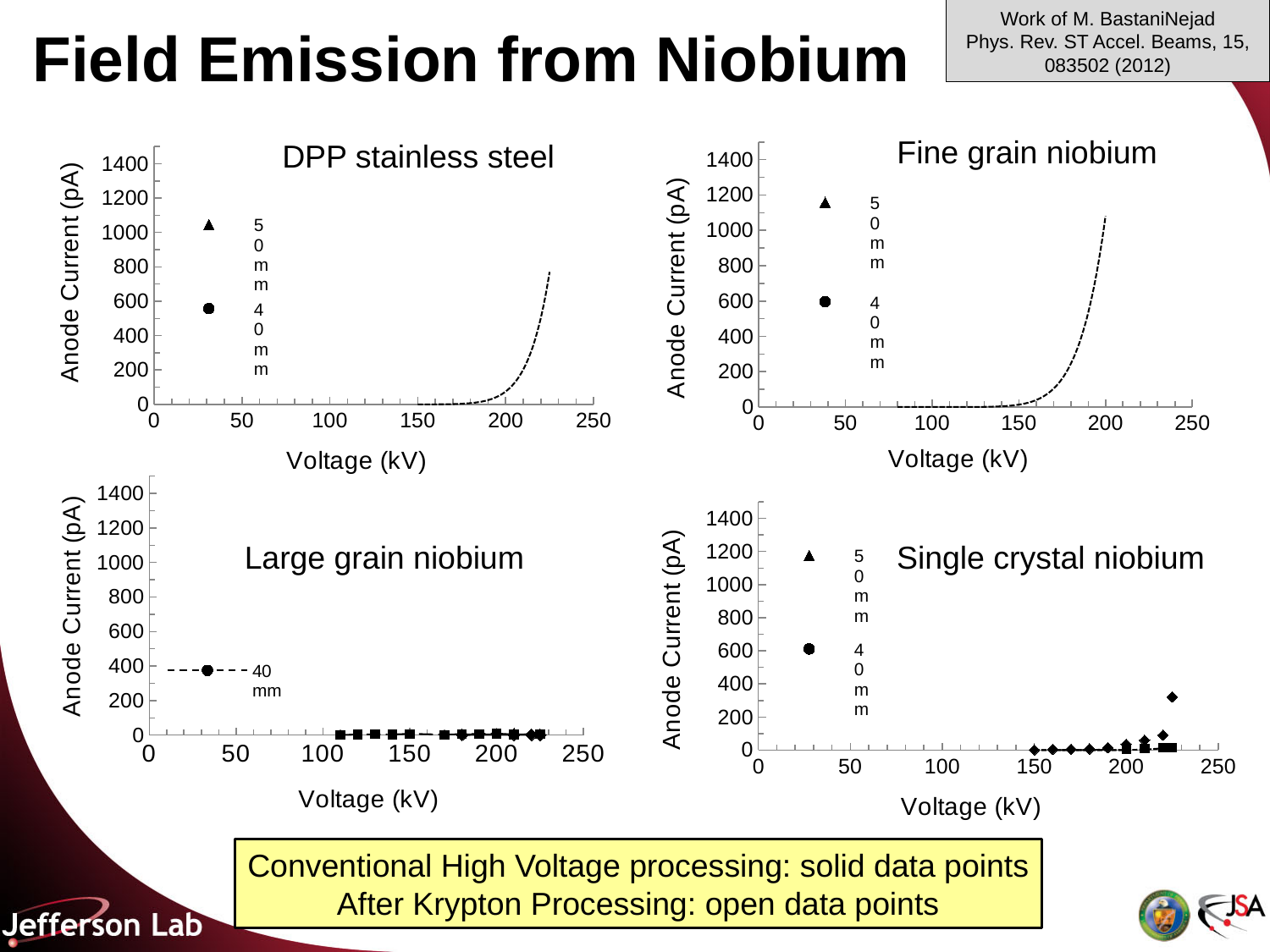
In the 'Large grain niobium' chart, are the plotted anode current values at voltages between 100 kV and 250 kV greater or less than 200 pA? less In the 'DPP stainless steel' chart, does the anode current rise or fall as voltage increases above 150 kV? Rise What is the y-axis label on the 'DPP stainless steel' chart? Anode Current (pA) In the 'Single crystal niobium' chart, is the highest plotted anode current greater or less than 400 pA? less What is the maximum value shown on the x-axis of the 'Fine grain niobium' chart? 250 In the 'Fine grain niobium' chart, does the anode current rise or fall as voltage increases from 150 kV to 200 kV? Rise Which chart shows the dashed curve reaching the highest anode current, 'DPP stainless steel' or 'Fine grain niobium'? Fine grain niobium What is the x-axis label on the 'Large grain niobium' chart? Voltage (kV) How many charts are shown on the slide? 4 In the 'DPP stainless steel' chart, is the anode current at the top of the dashed curve (around 225 kV) greater or less than 600 pA? greater What kind of chart is the 'Fine grain niobium' chart? Scatter/line chart